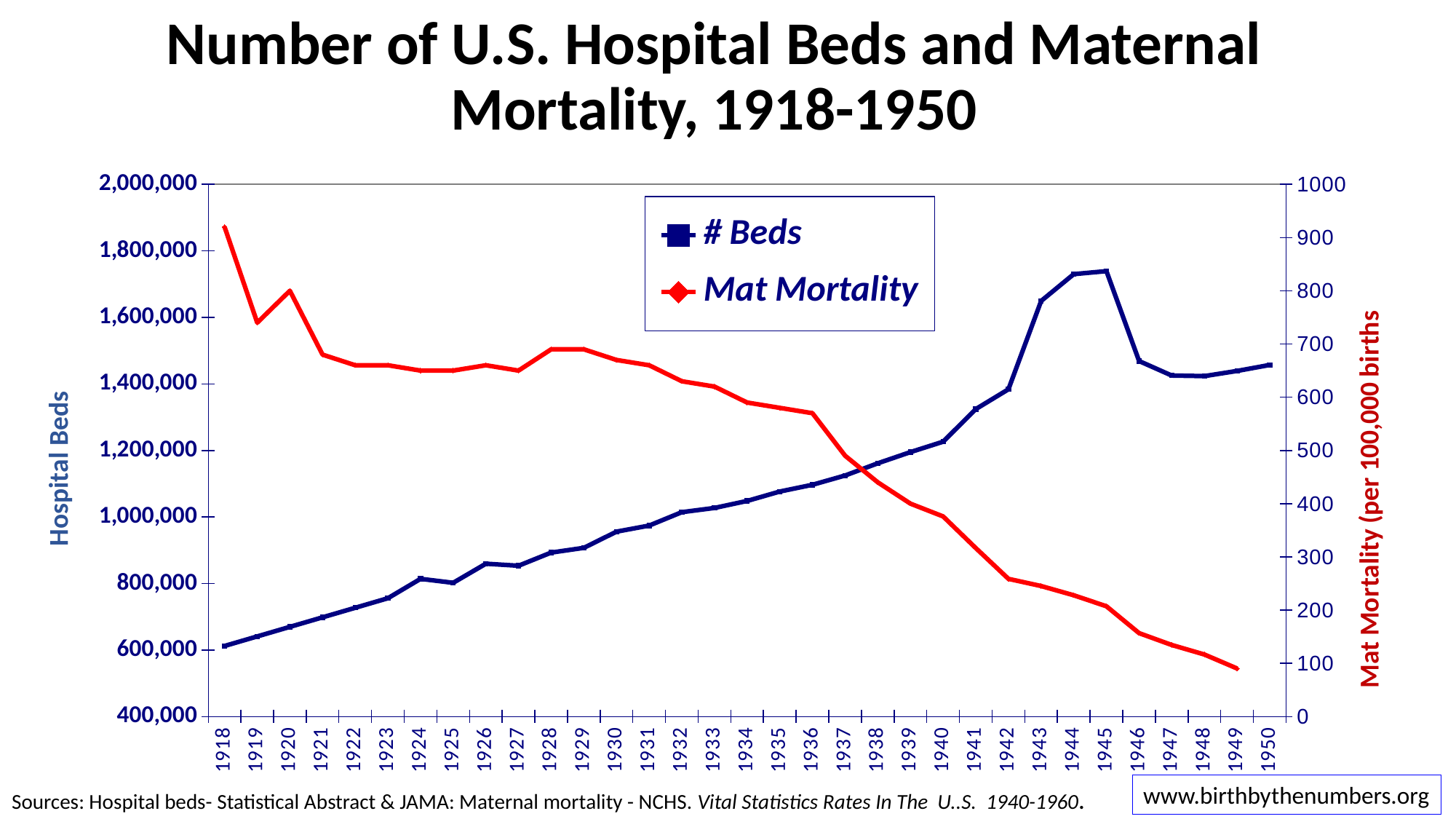
Does the # Beds series generally rise or fall from 1918 to 1945? Rise Is the # Beds value for 1945 greater or less than 1,600,000? greater Is the Mat Mortality value for 1940 greater or less than 500? less In which year is the Mat Mortality value highest? 1918 In which year is the # Beds value lowest? 1918 Is the # Beds value for 1918 greater or less than 800,000? less How many years are labelled along the x axis? 33 Which year has the larger Mat Mortality value, 1920 or 1921? 1920 How many series does the legend list? 2 In which year is the Mat Mortality value lowest? 1949 Does the Mat Mortality series generally rise or fall from 1918 to 1949? Fall What kind of chart is shown on the slide? Line chart